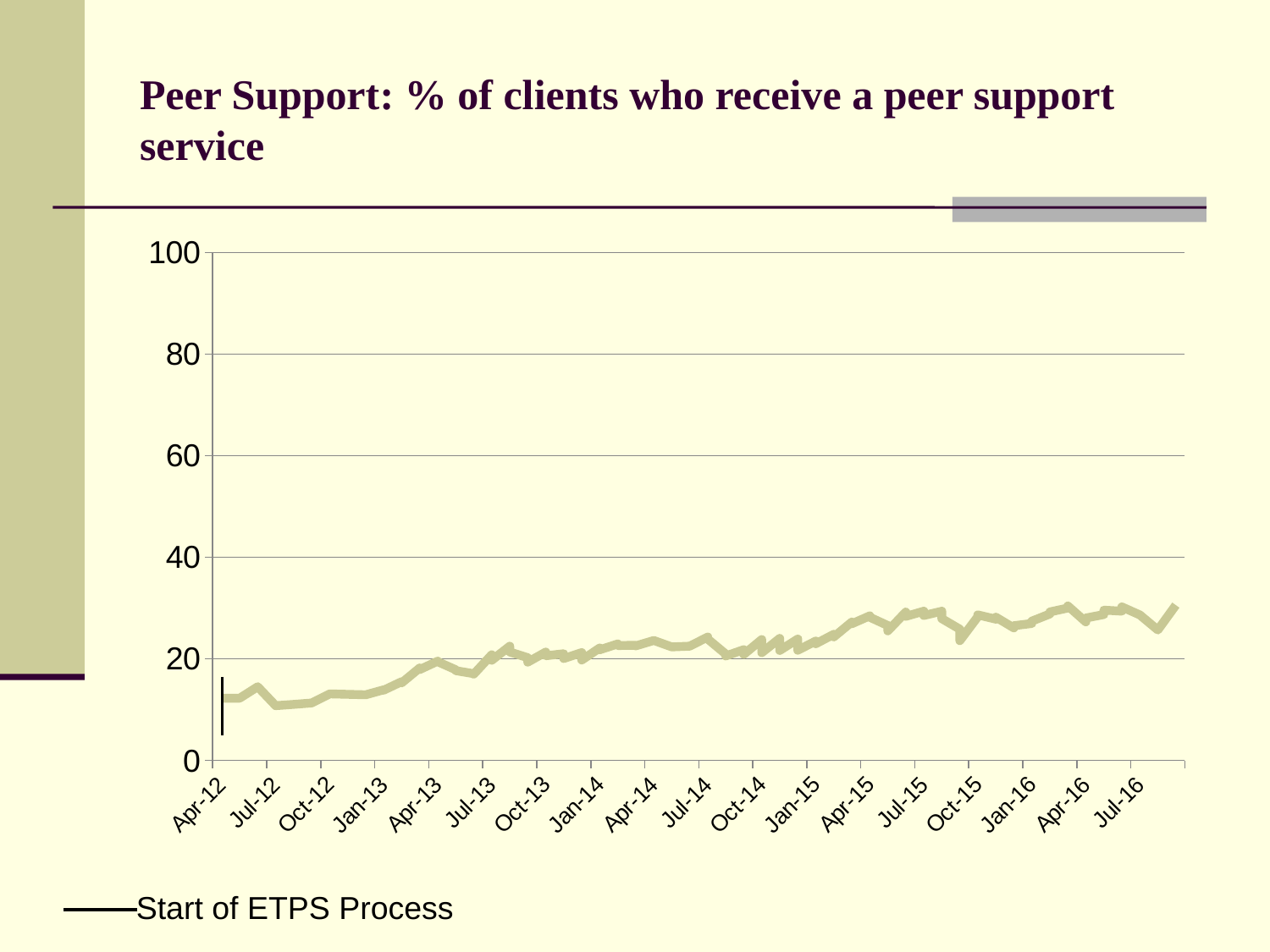
Is the value for Jul-12 greater or less than 20? less Is the value for Jan-13 greater or less than 20? less Is the value for Apr-12 greater or less than 20? less What kind of chart is shown on the slide? line chart What is the title of the chart on the slide? Peer Support: % of clients who receive a peer support service Overall, do the values rise or fall from Apr-12 to Jul-16? rise What does the legend entry below the chart say? Start of ETPS Process Which is larger, the value for Jul-12 or the value for Jul-16? Jul-16